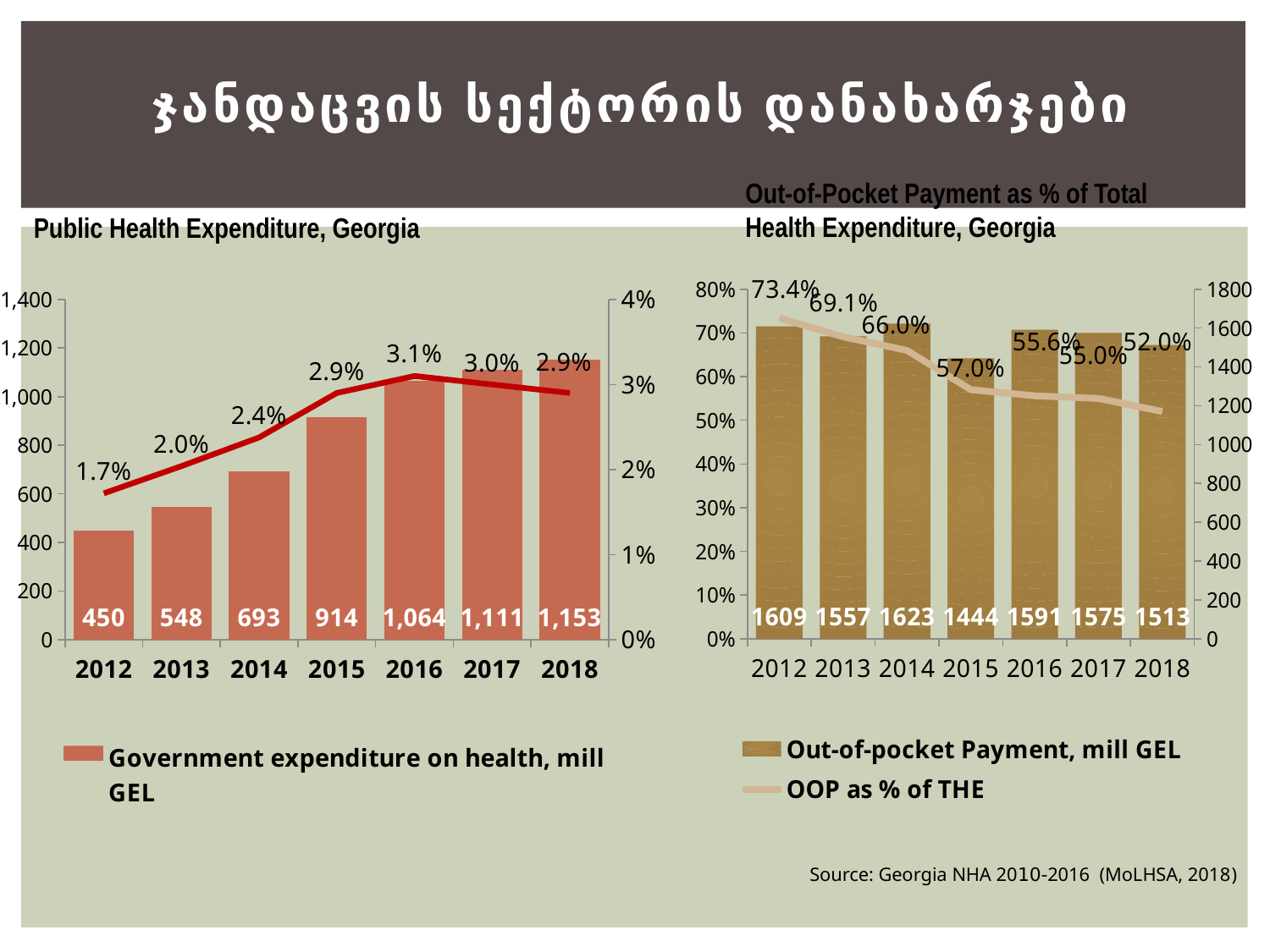
In the Public Health Expenditure, Georgia chart, what is the difference between government expenditure on health in 2018 and 2012? 703 In the Out-of-Pocket Payment as % of Total Health Expenditure, Georgia chart, what is OOP as % of THE in 2018? 52.0% In the Public Health Expenditure, Georgia chart, which year has the lowest government expenditure on health? 2012 In the Public Health Expenditure, Georgia chart, which year has the highest government expenditure on health? 2018 In the Public Health Expenditure, Georgia chart, what percentage is shown on the line for 2016? 3.1% In the Out-of-Pocket Payment as % of Total Health Expenditure, Georgia chart, what is the out-of-pocket payment in mill GEL for 2014? 1623 How many series does the legend of the Out-of-Pocket Payment as % of Total Health Expenditure, Georgia chart list? 2 In the Public Health Expenditure, Georgia chart, what is the government expenditure on health in 2015? 914 In the Out-of-Pocket Payment as % of Total Health Expenditure, Georgia chart, is the out-of-pocket payment larger in 2012 or 2013? 2012 How many years are shown on the x axis of the Public Health Expenditure, Georgia chart? 7 In the Public Health Expenditure, Georgia chart, do the bar values rise or fall from 2012 to 2018? rise In the Out-of-Pocket Payment as % of Total Health Expenditure, Georgia chart, which year has the lowest out-of-pocket payment in mill GEL? 2015